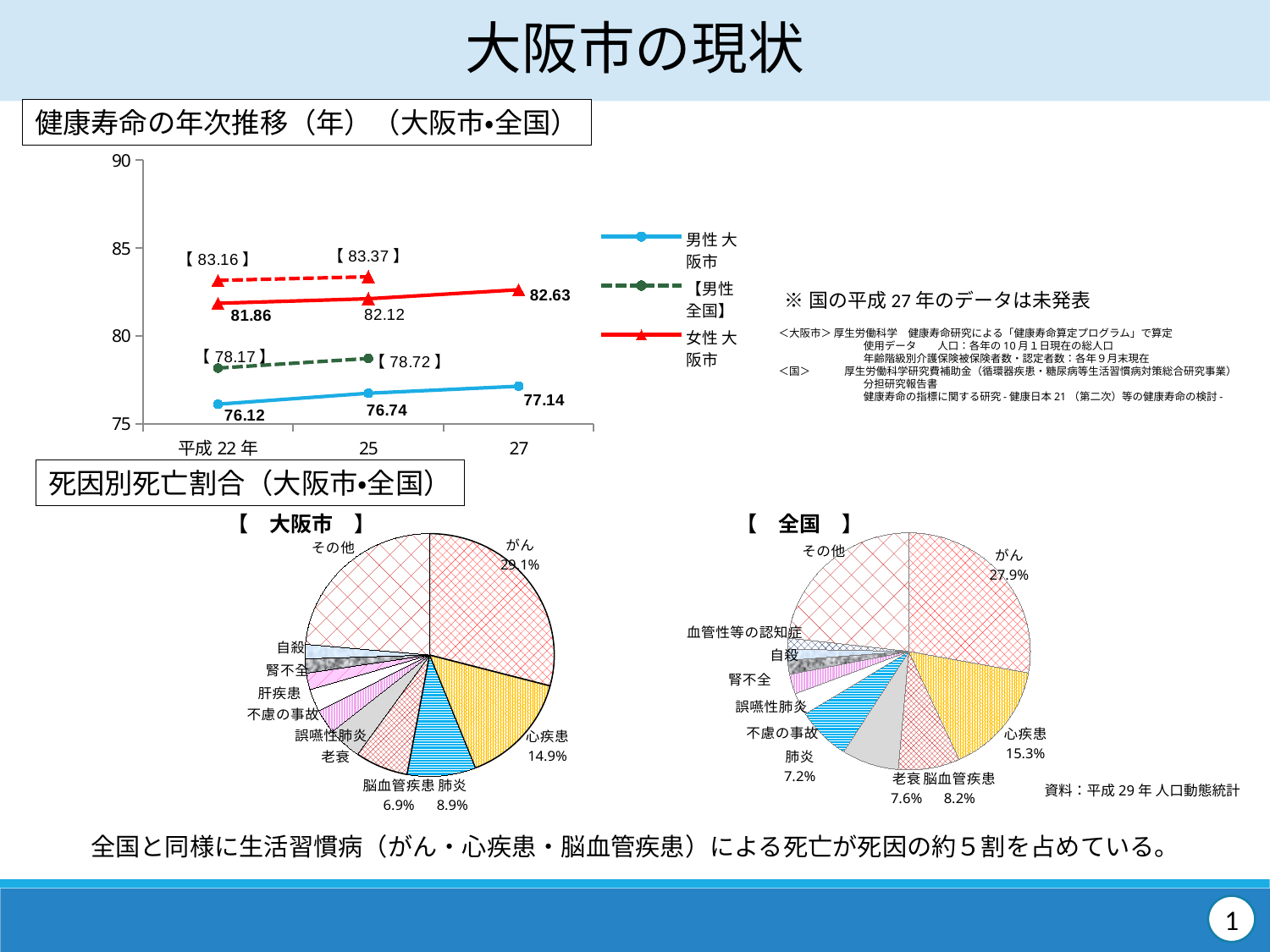
In the line chart 健康寿命の年次推移, what is the value for 男性 全国 in 平成25年? 78.72 In the line chart 健康寿命の年次推移, what is the value for 女性 大阪市 in 平成22年? 81.86 In the line chart 健康寿命の年次推移, what is the value for 女性 全国 in 平成22年? 83.16 In the line chart 健康寿命の年次推移, what is the difference between 女性 大阪市 and 男性 大阪市 in 平成27年? 5.49 In the line chart 健康寿命の年次推移, does the value for 男性 大阪市 rise or fall from 平成22年 to 平成27年? rise In the line chart 健康寿命の年次推移, which is larger in 平成25年: 男性 全国 or 男性 大阪市? 男性 全国 In the 大阪市 pie chart, what is the difference between 肺炎 and 脳血管疾患? 2.0% In the 全国 pie chart, what share is 心疾患? 15.3% In the 大阪市 pie chart, what share is がん? 29.1% Which is larger: がん in the 大阪市 pie chart or がん in the 全国 pie chart? 大阪市 What kind of chart is 健康寿命の年次推移? line chart In the line chart 健康寿命の年次推移, what is the value for 男性 大阪市 in 平成27年? 77.14